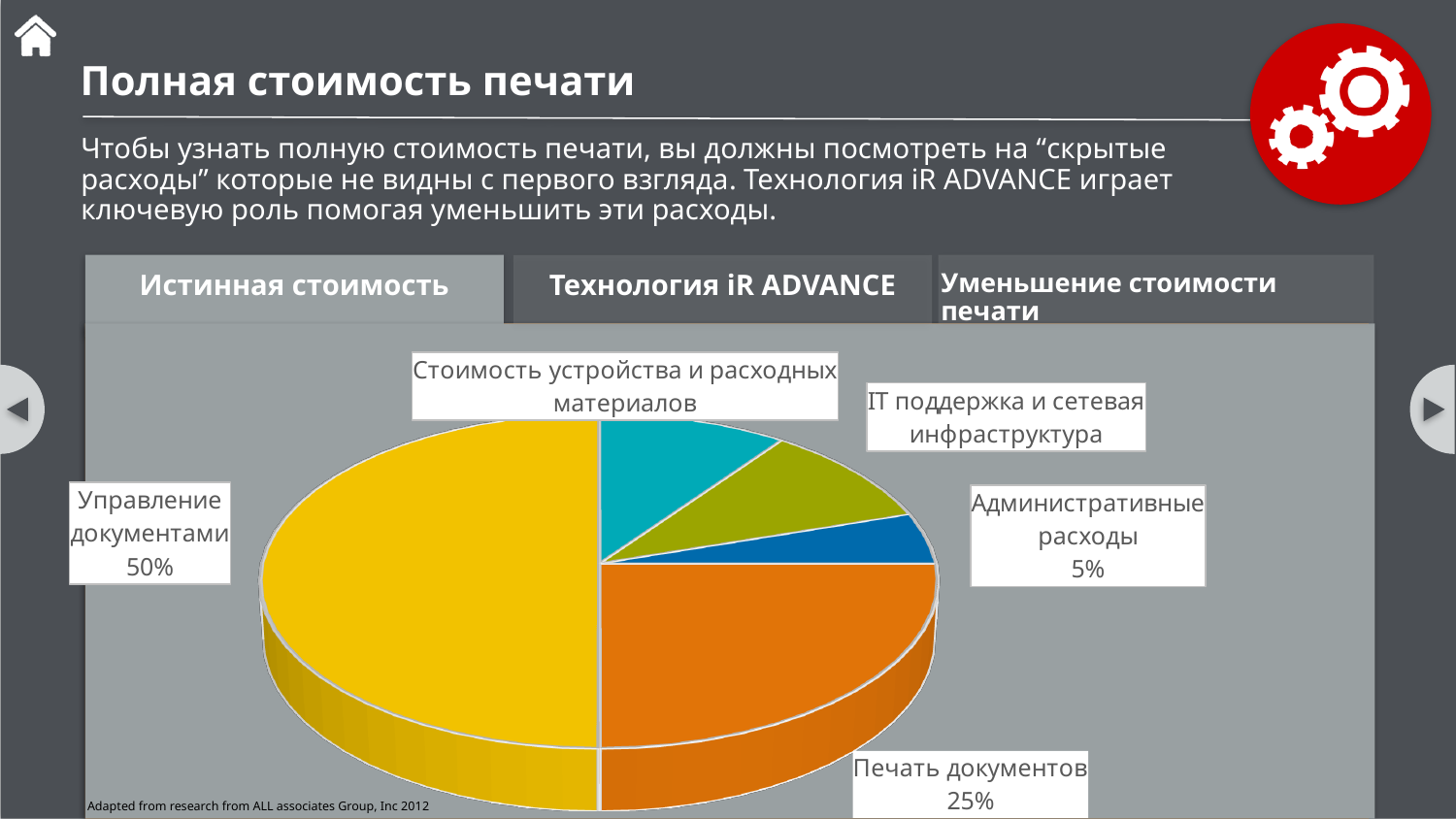
Which is larger, the slice for "Управление документами" or the slice for "Печать документов"? Управление документами How many slices does the pie chart have? 5 What kind of chart is shown on the slide? pie chart What is the difference between the values for "Управление документами" and "Печать документов"? 25% What is the value shown for "Печать документов"? 25% What is the difference between the values for "Печать документов" and "Административные расходы"? 20% What share of the pie does "Управление документами" take? 50% What is the value shown for "Административные расходы"? 5% What is the title of the slide containing the pie chart? Полная стоимость печати Which category has the smallest slice of the pie? Административные расходы What colour is the slice for "Печать документов"? orange Which category has the largest slice of the pie? Управление документами